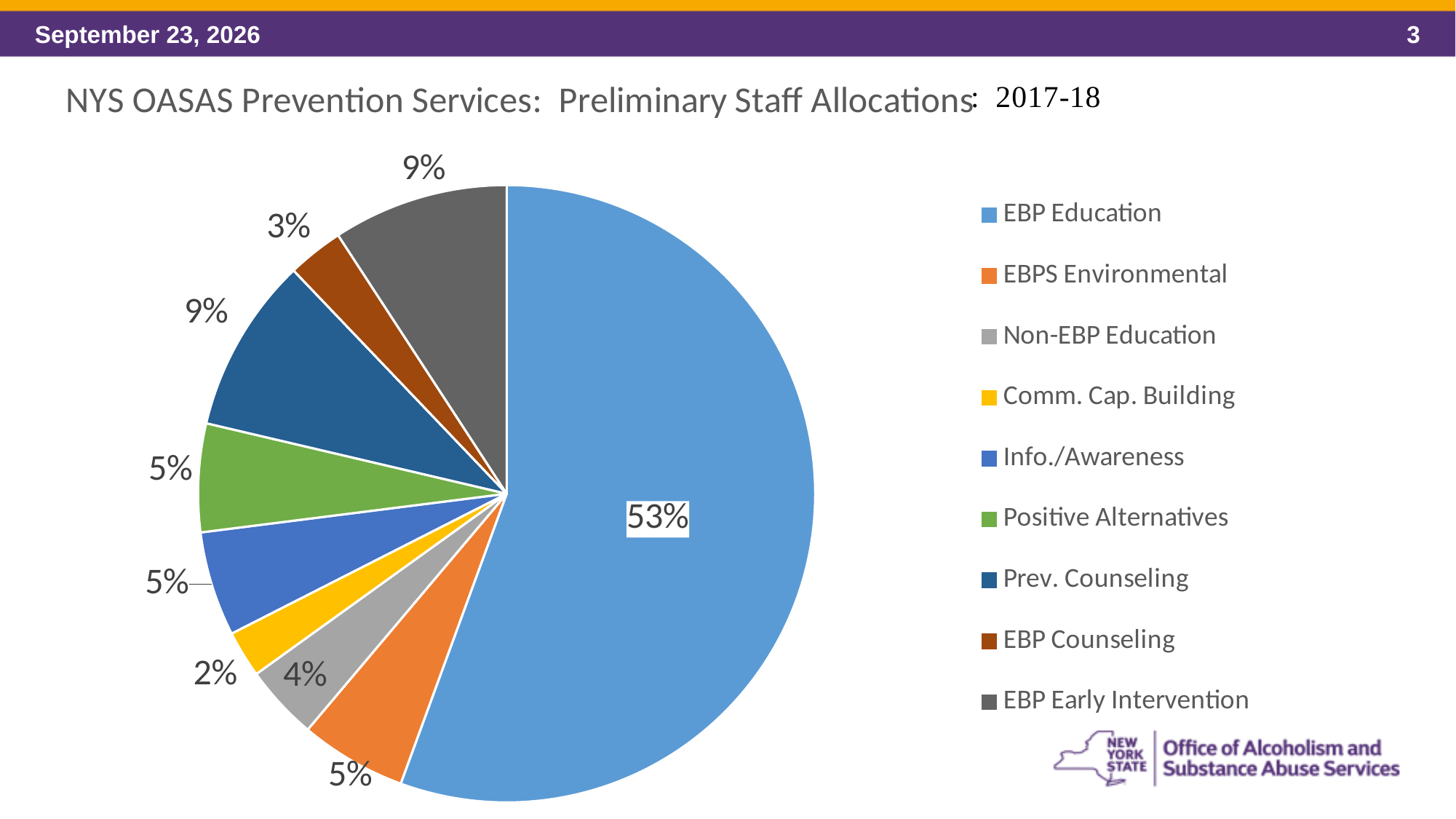
Which category has the largest share of the pie? EBP Education What is the title of the chart? NYS OASAS Prevention Services: Preliminary Staff Allocations: 2017-18 Which category has the smallest share of the pie? Comm. Cap. Building What type of chart is shown on the slide? Pie chart What percentage is shown for Comm. Cap. Building? 2% What percentage is shown for Non-EBP Education? 4% What percentage is shown for Prev. Counseling? 9% How many slices does the pie chart have? 9 What is the difference in percentage points between EBP Education and EBP Early Intervention? 44 What percentage is shown for EBP Counseling? 3% What share of the pie does EBP Education represent? 53% Which is larger, the share for Prev. Counseling or the share for EBP Counseling? Prev. Counseling